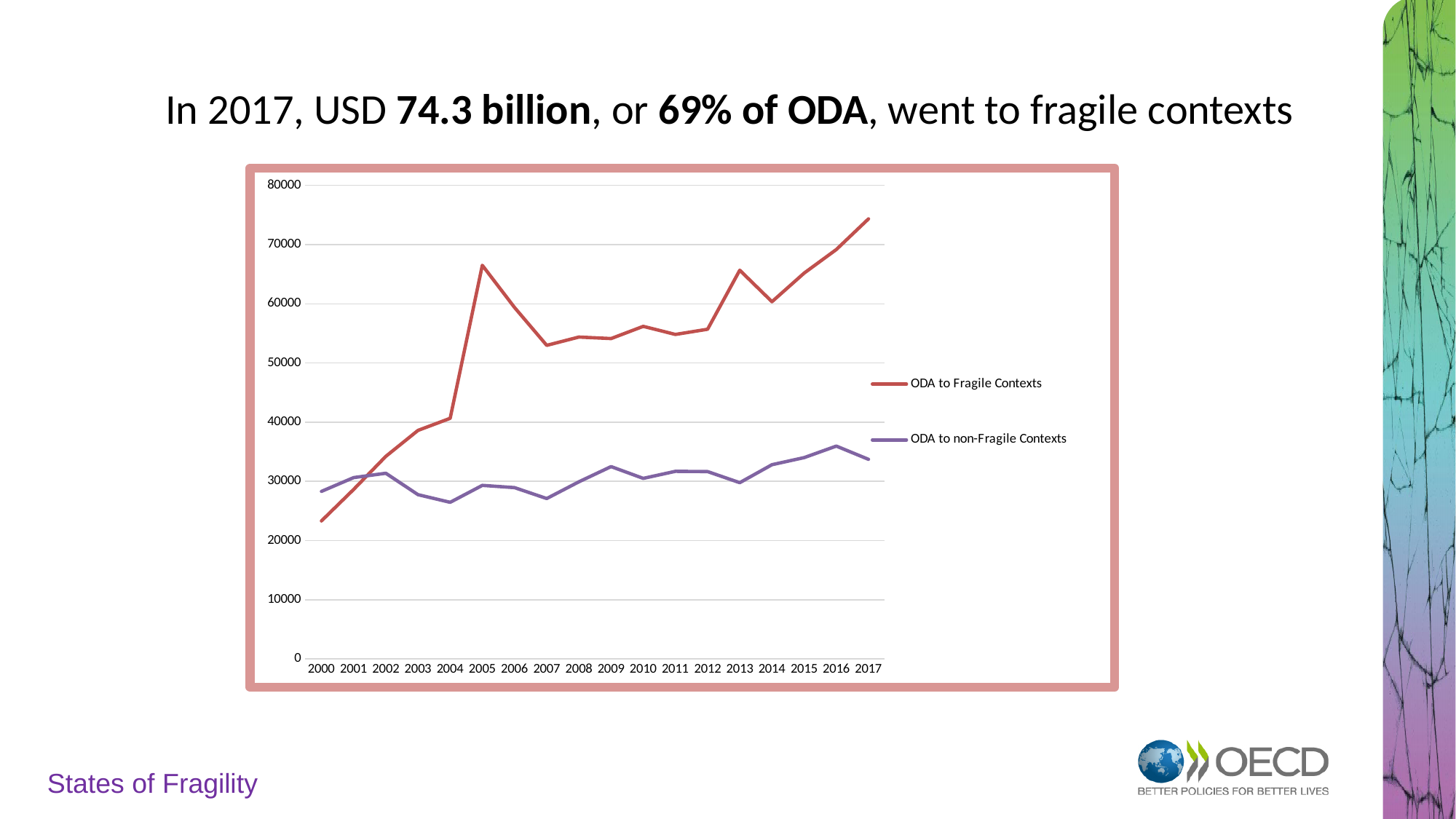
What kind of chart is shown on the slide? line chart How many series does the legend list? 2 Is the value for ODA to Fragile Contexts in 2017 greater or less than 70000? greater In which year is ODA to non-Fragile Contexts highest? 2016 What colour is the line for ODA to Fragile Contexts? red In which year is ODA to Fragile Contexts highest? 2017 In 2000, which series has the larger value, ODA to Fragile Contexts or ODA to non-Fragile Contexts? ODA to non-Fragile Contexts Is the value for ODA to Fragile Contexts in 2000 greater or less than 30000? less How many years are shown along the x axis? 18 In which year is ODA to Fragile Contexts lowest? 2000 Does ODA to Fragile Contexts rise or fall overall from 2000 to 2017? rise Is the value for ODA to non-Fragile Contexts in 2004 greater or less than 30000? less